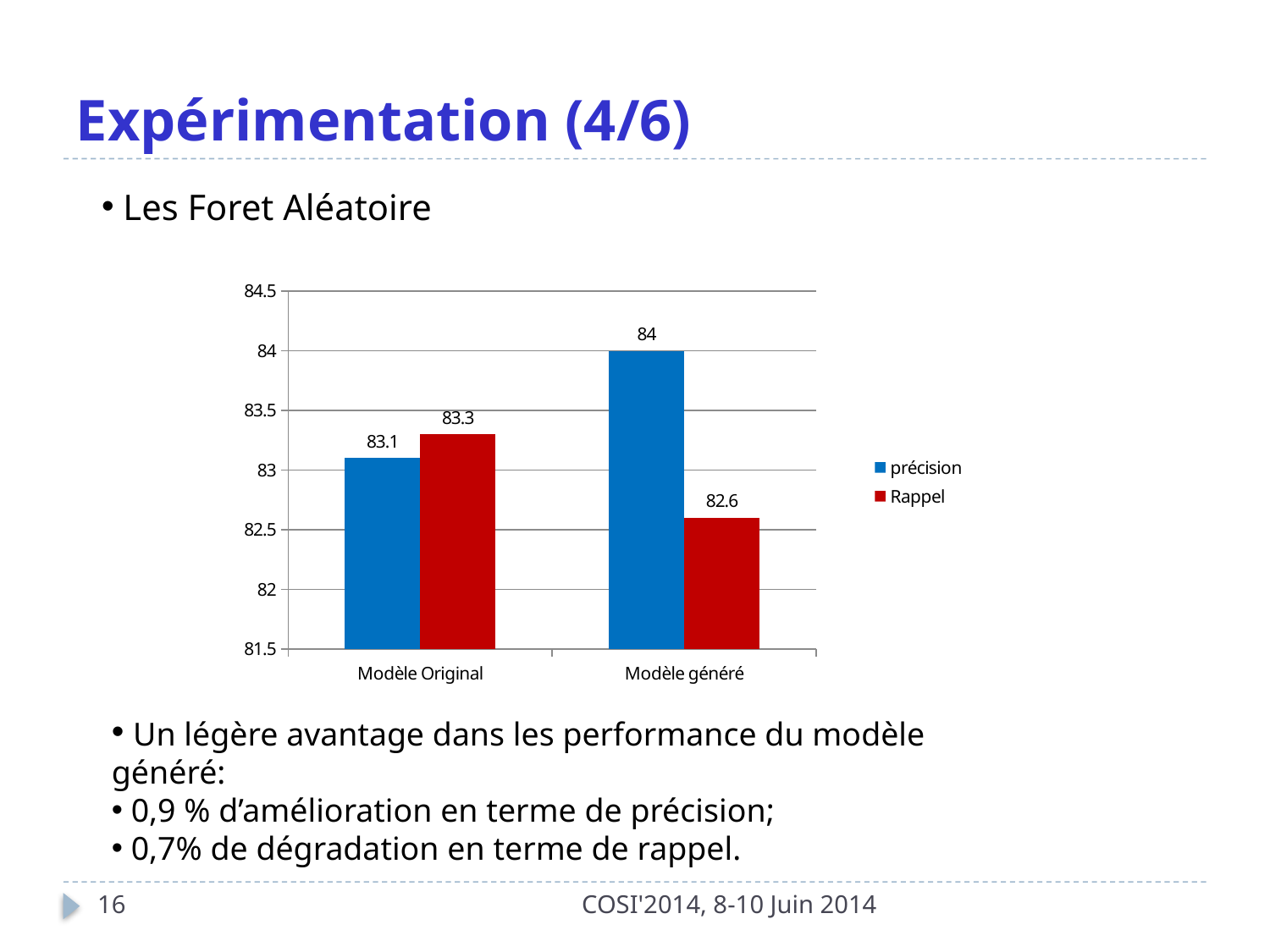
What kind of chart is shown on the slide? Bar chart How many categories are shown on the x axis? 2 What is the précision value for Modèle Original? 83.1 How many series does the legend list? 2 Which category has the lowest Rappel value? Modèle généré What is the difference between the précision values of Modèle généré and Modèle Original? 0.9 Which is larger for Modèle Original: précision or Rappel? Rappel What is the Rappel value for Modèle Original? 83.3 What is the Rappel value for Modèle généré? 82.6 What is the difference between the Rappel values of Modèle Original and Modèle généré? 0.7 What is the précision value for Modèle généré? 84 Which category has the highest précision value? Modèle généré